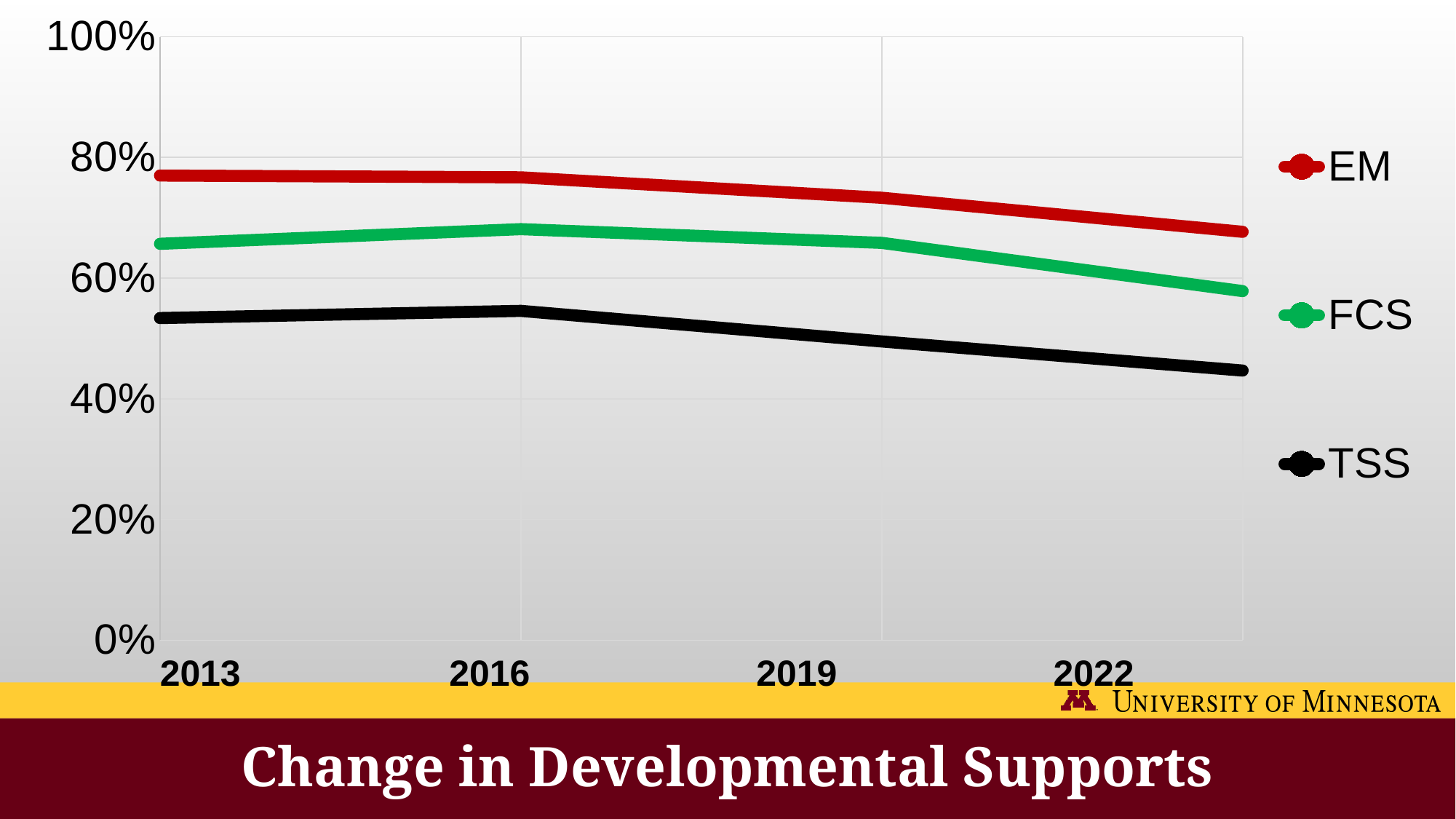
Which series has the lowest value in 2013? TSS Is the value for EM in 2013 greater or less than 60%? greater Does the TSS line rise or fall between 2016 and 2022? fall Is the value for FCS in 2022 greater or less than 40%? greater What colour is the line for FCS? green What kind of chart is shown on the slide? line chart Is the value for TSS in 2022 greater or less than 60%? less Which is larger in 2019, the value for FCS or the value for TSS? FCS How many series does the legend list? 3 How many years are labelled on the x axis? 4 Which series has the highest value in 2022? EM What is the title shown on the slide? Change in Developmental Supports